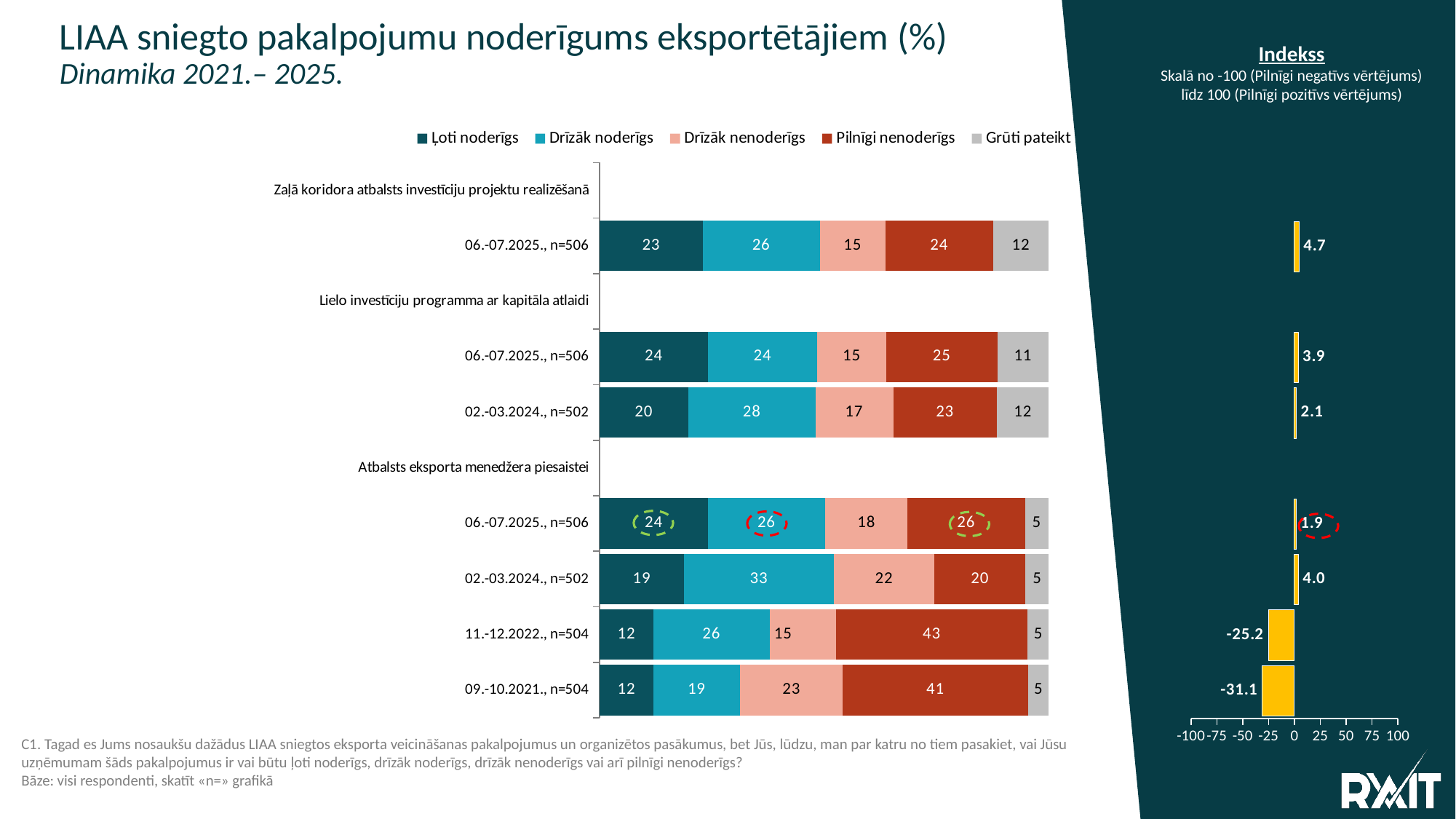
In the 'Indekss' chart, what is the difference between the index values for 'Atbalsts eksporta menedžera piesaistei' in 02.-03.2024., n=502 and 06.-07.2025., n=506? 2.1 In the stacked bar chart, what is the 'Pilnīgi nenoderīgs' value for 'Atbalsts eksporta menedžera piesaistei' in 11.-12.2022., n=504? 43 In the stacked bar chart, what is the total of the bar for 'Atbalsts eksporta menedžera piesaistei' in 02.-03.2024., n=502? 99 What type of chart is the main chart on the left of the slide? Stacked bar chart In the stacked bar chart, what is the 'Ļoti noderīgs' value for 'Zaļā koridora atbalsts investīciju projektu realizēšanā' in 06.-07.2025., n=506? 23 In the stacked bar chart, which is larger for 'Atbalsts eksporta menedžera piesaistei' in 09.-10.2021., n=504: 'Drīzāk noderīgs' or 'Drīzāk nenoderīgs'? Drīzāk nenoderīgs In the stacked bar chart, what is the 'Drīzāk noderīgs' value for 'Lielo investīciju programma ar kapitāla atlaidi' in 02.-03.2024., n=502? 28 In the 'Indekss' chart, what is the index value for 'Zaļā koridora atbalsts investīciju projektu realizēšanā' in 06.-07.2025., n=506? 4.7 In the stacked bar chart, what is the difference between the 'Pilnīgi nenoderīgs' values for 'Atbalsts eksporta menedžera piesaistei' in 11.-12.2022., n=504 and 06.-07.2025., n=506? 17 In the stacked bar chart, how many dated bars are shown in total? 7 In the 'Indekss' chart, which period has the lowest index value? 09.-10.2021., n=504 In the stacked bar chart, how many series does the legend list? 5